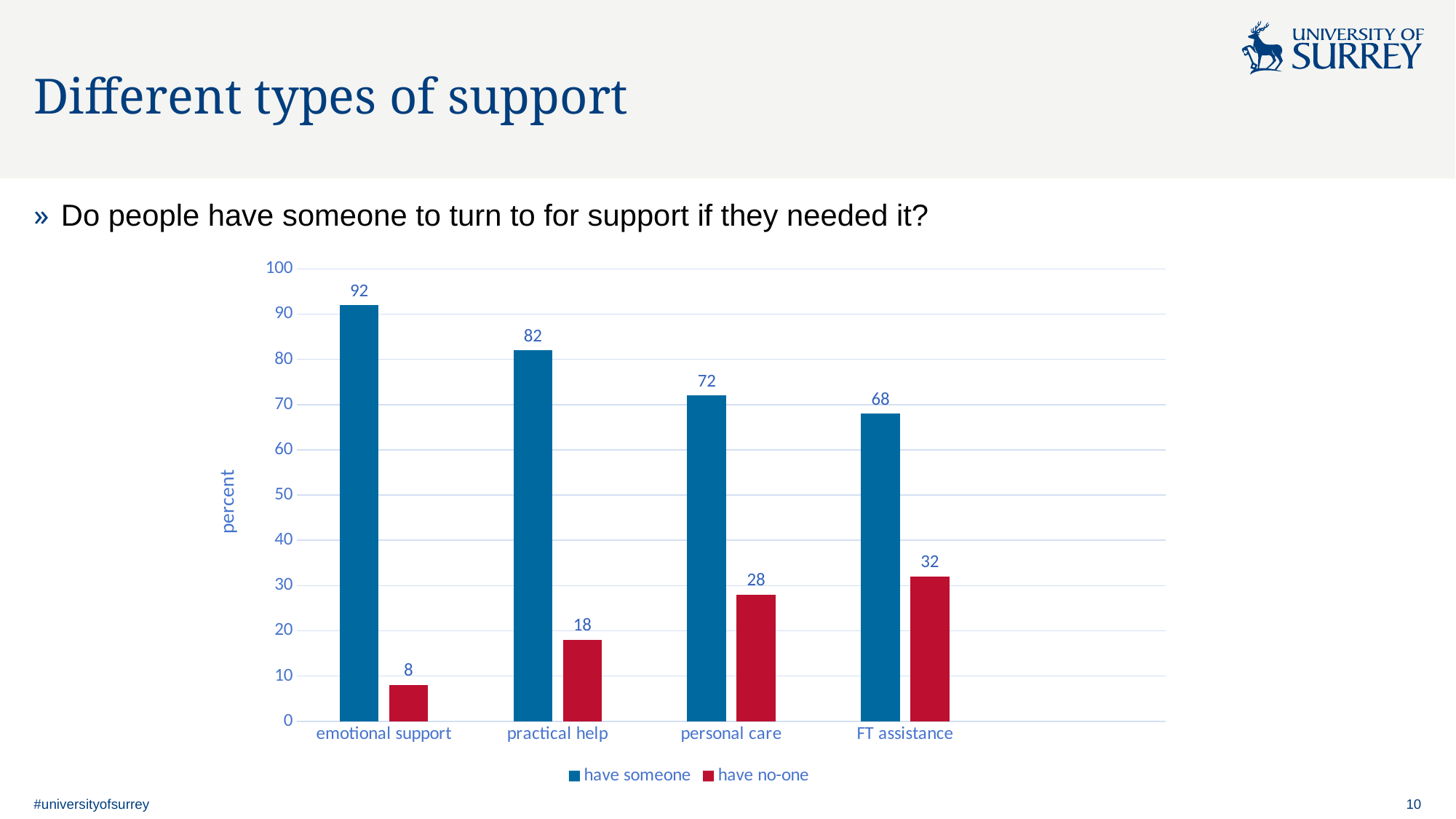
What is the value for "have someone" for emotional support? 92 Which category has the highest "have someone" value? emotional support How many series does the legend list? 2 Is the "have someone" value for FT assistance greater or less than 60? greater Which category has the lowest "have no-one" value? emotional support What is the value for "have no-one" for practical help? 18 What is the difference between the "have someone" and "have no-one" values for personal care? 44 Which is larger: the "have no-one" value for personal care or for FT assistance? FT assistance What kind of chart is shown on the slide? bar chart What is the value for "have no-one" for FT assistance? 32 What is the label on the y axis? percent How many categories are shown on the x axis? 4